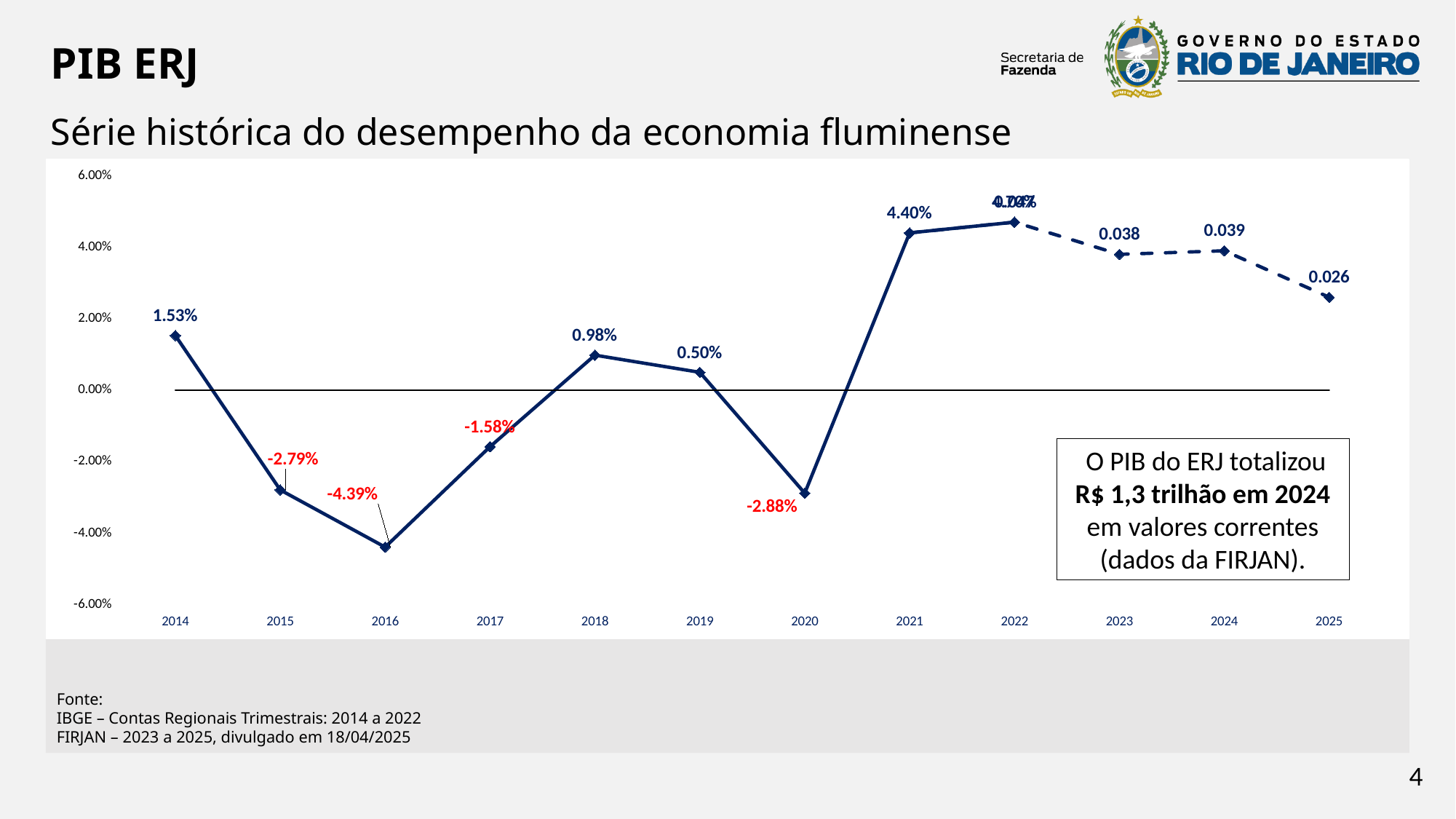
What is the value shown for 2025? 0.026 How many years are shown on the x axis? 12 Is the value for 2023 greater or less than 2.00%? greater What is the value for 2016? -4.39% What type of chart is shown on the slide? line chart What is the value for 2014? 1.53% What is the value for 2021? 4.40% Which year has the lowest value? 2016 Which is larger, the value for 2018 or the value for 2019? 2018 What is the difference between the values for 2018 and 2019? 0.48% What is the value for 2020? -2.88% Do the values rise or fall from 2014 to 2016? fall